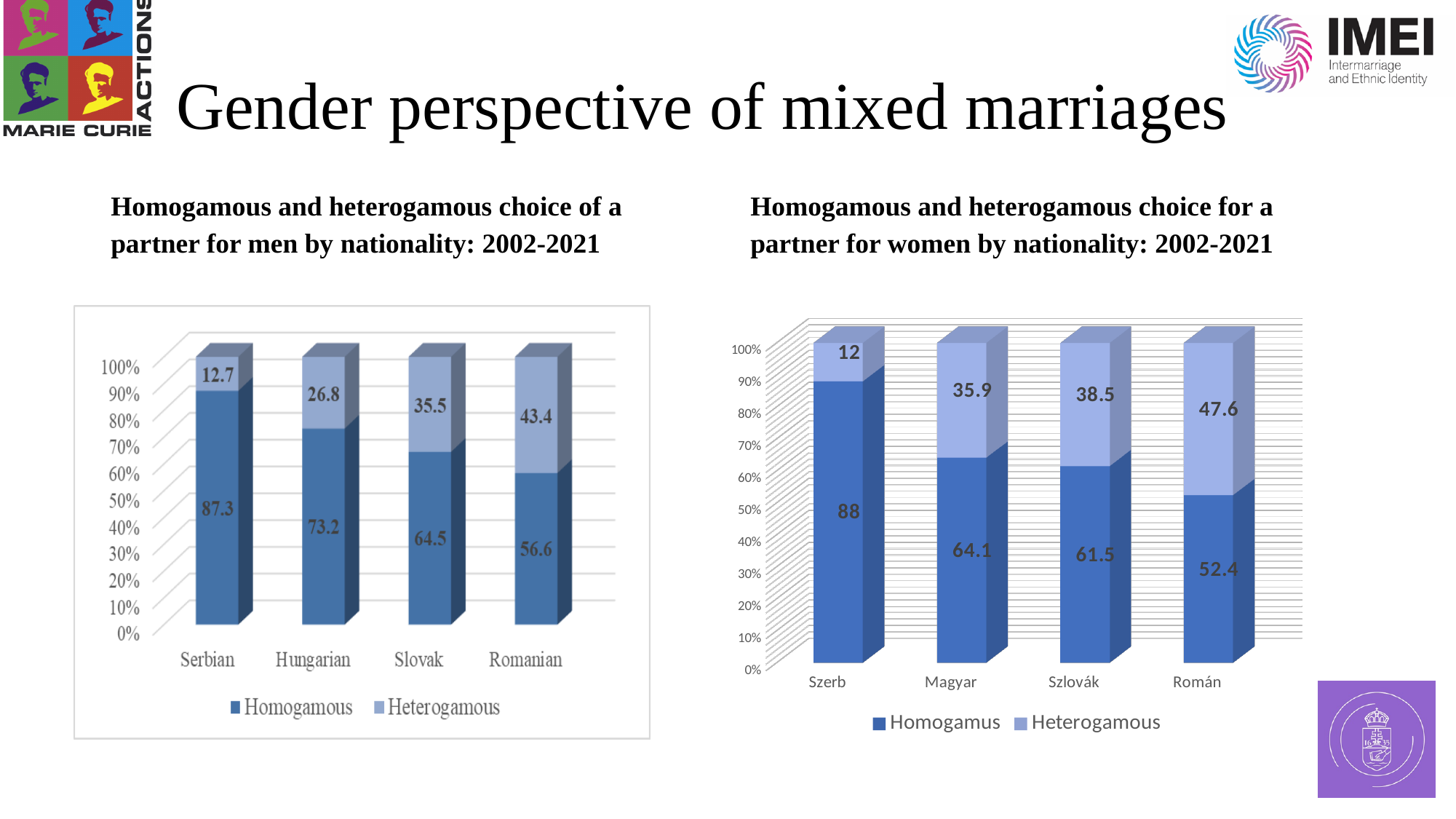
In the left chart (men by nationality), what is the Homogamous value for Serbian? 87.3 How many nationality categories are shown in the left chart (men by nationality)? 4 In the right chart (women by nationality), what is the Heterogamous value for Szlovák? 38.5 In the left chart (men by nationality), what is the difference between the Homogamous values for Hungarian and Slovak? 8.7 In the right chart (women by nationality), which nationality has the lowest Homogamus value? Román How many series does the legend of the right chart (women by nationality) list? 2 In the left chart (men by nationality), which nationality has the highest Homogamous value? Serbian What kind of chart is the left chart (men by nationality)? Stacked bar chart In the left chart (men by nationality), what is the Heterogamous value for Romanian? 43.4 In the right chart (women by nationality), what is the Homogamus value for Magyar? 64.1 In the right chart (women by nationality), which is larger: the Heterogamous value for Magyar or for Román? Román In the right chart (women by nationality), do the Homogamus values rise or fall from Szerb to Román? Fall